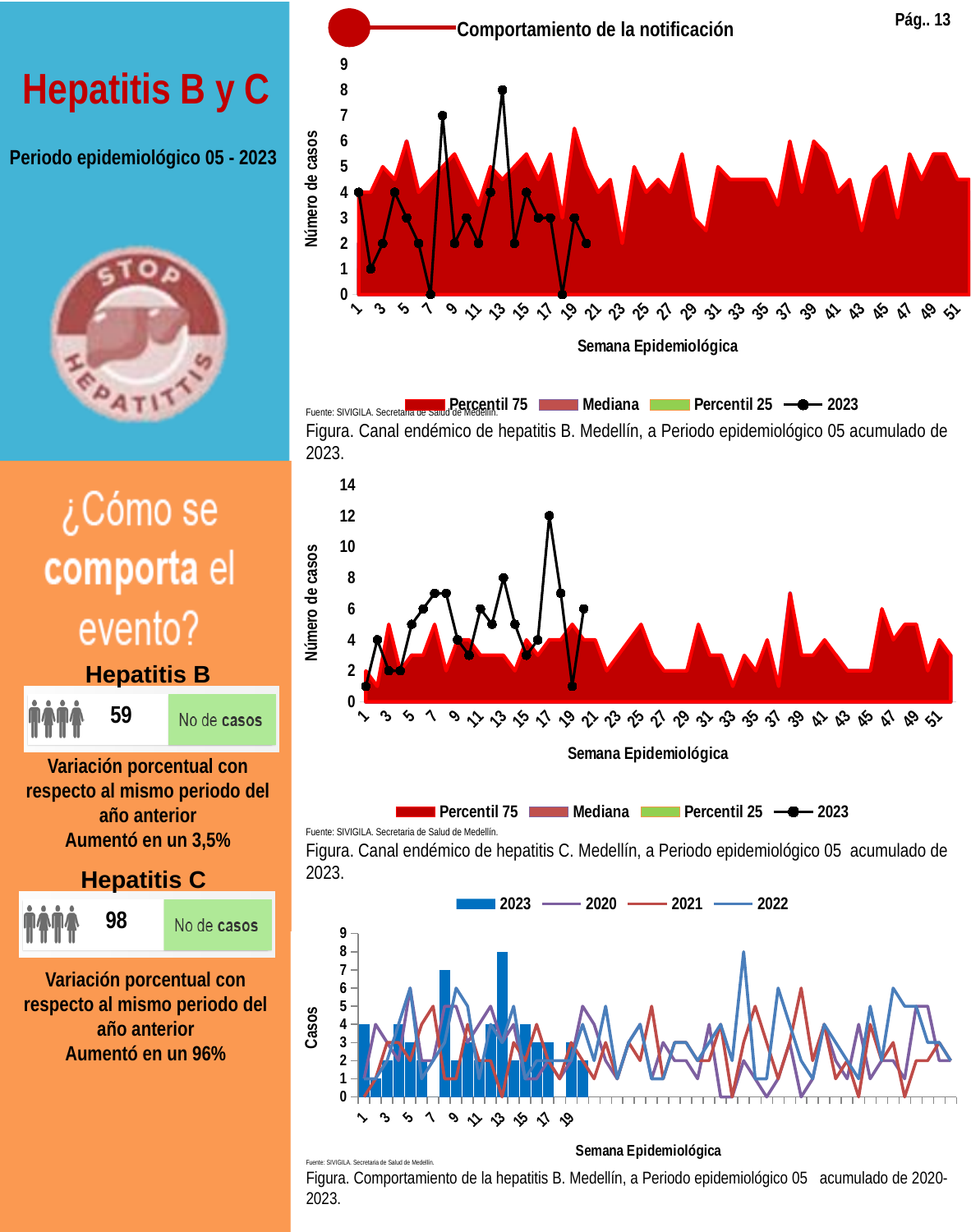
In the top chart (Canal endémico de hepatitis B), how many series does the legend list? 4 In the middle chart (Canal endémico de hepatitis C), what is the value of the 2023 line at week 17? 12 In the top chart (Canal endémico de hepatitis B), is the 2023 value at week 8 greater or less than 5? greater In the middle chart (Canal endémico de hepatitis C), is the 2023 value at week 17 greater or less than 10? greater In the bottom chart (Comportamiento de la hepatitis B), what kind of chart is used for the 2023 series? bar chart In the top chart (Canal endémico de hepatitis B), what is the value of the 2023 line at week 13? 8 In the bottom chart (Comportamiento de la hepatitis B), which 2023 bar is taller, week 8 or week 13? Week 13 In the middle chart (Canal endémico de hepatitis C), at which epidemiological week does the 2023 line peak? Week 17 In the top chart (Canal endémico de hepatitis B), at which epidemiological week does the 2023 line reach its highest value? Week 13 In the bottom chart (Comportamiento de la hepatitis B), how many series does the legend list? 4 In the top chart (Canal endémico de hepatitis B), what is the title of the x axis? Semana Epidemiológica In the bottom chart (Comportamiento de la hepatitis B), which week has the tallest 2023 bar? Week 13